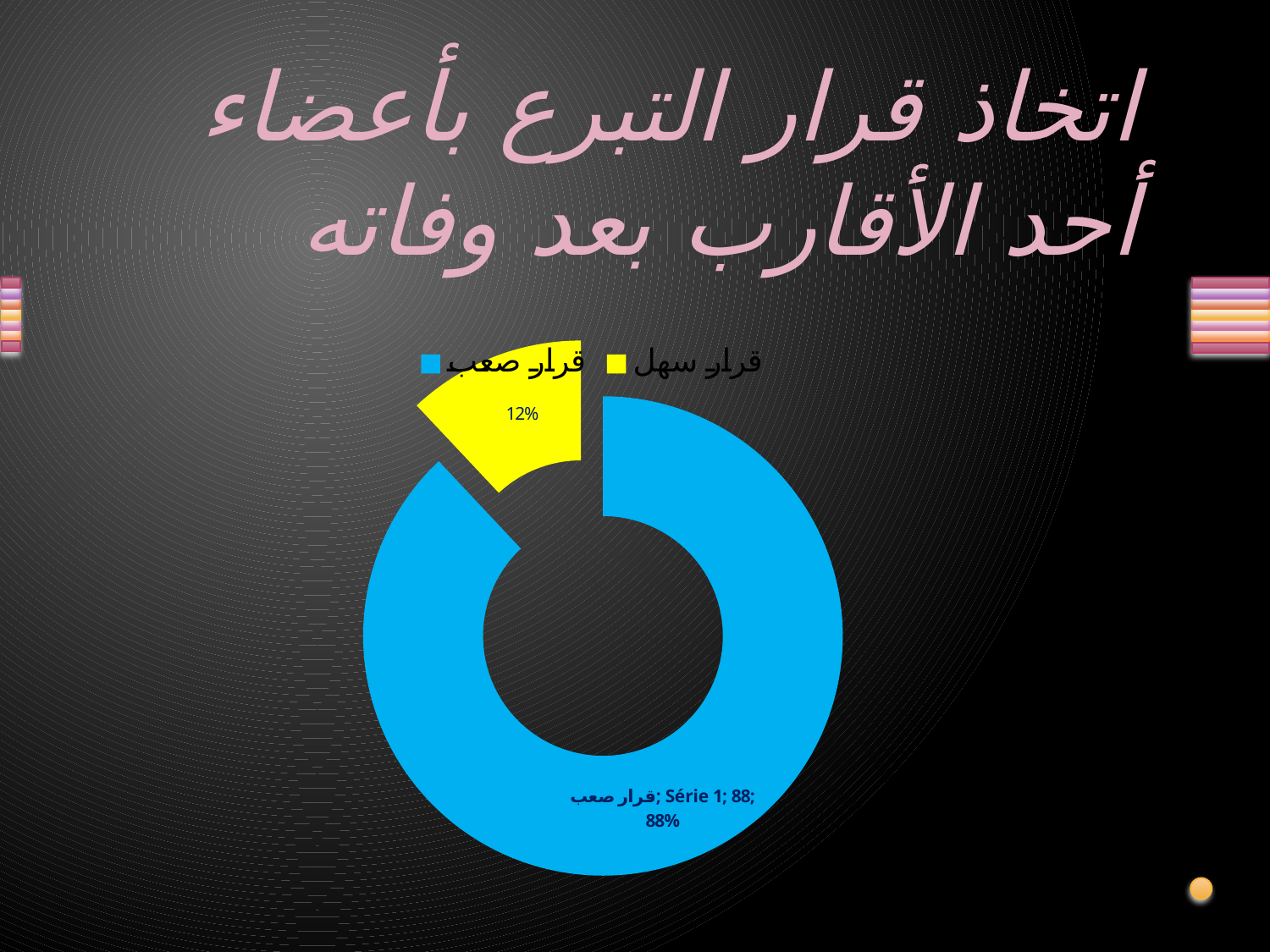
What is the value printed in the data label for قرار صعب? 88 How many categories does the doughnut chart show? 2 What colour is the slice for قرار سهل? Yellow How many entries does the legend list? 2 What is the difference in percentage points between قرار صعب and قرار سهل? 76 What percentage is shown for قرار صعب? 88% What kind of chart is shown on the slide? Doughnut chart Which is larger, the share for قرار صعب or the share for قرار سهل? قرار صعب Which category has the smallest share of the doughnut? قرار سهل What series name appears in the data label on the blue slice? Série 1 Which category has the largest share of the doughnut? قرار صعب What percentage is shown for قرار سهل? 12%